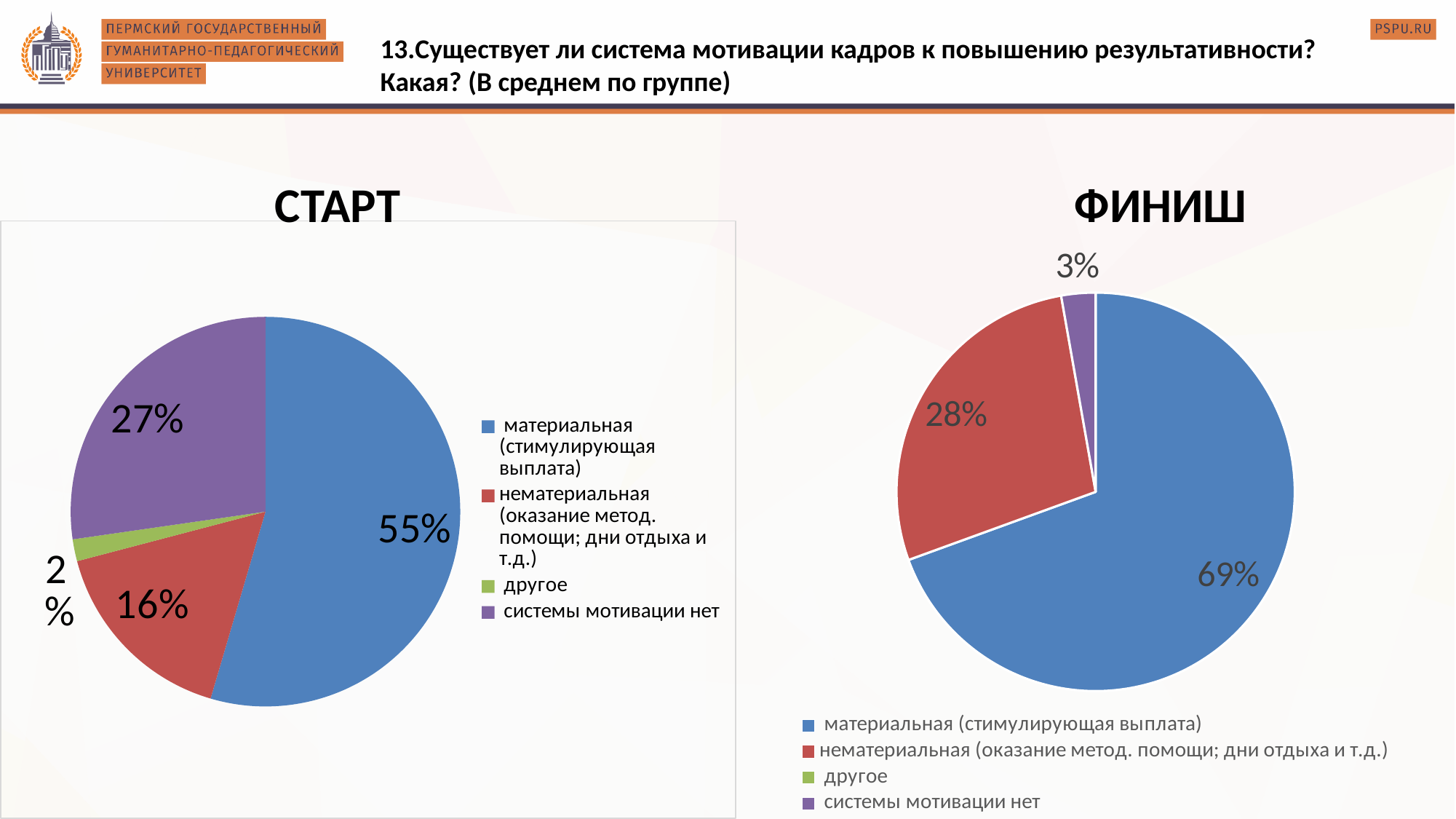
In the СТАРТ chart, what share is labelled for the материальная (стимулирующая выплата) slice? 55% In the СТАРТ chart, what percentage is shown for другое? 2% In the СТАРТ chart, what percentage is shown for нематериальная (оказание метод. помощи; дни отдыха и т.д.)? 16% How many entries does the legend of the ФИНИШ chart list? 4 In the ФИНИШ chart, what percentage is shown for системы мотивации нет? 3% In the ФИНИШ chart, what share is labelled for the материальная (стимулирующая выплата) slice? 69% In the СТАРТ chart, which category has the smallest slice? другое What is the difference between the материальная (стимулирующая выплата) share in the ФИНИШ chart and in the СТАРТ chart? 14% In the ФИНИШ chart, what percentage is shown for нематериальная (оказание метод. помощи; дни отдыха и т.д.)? 28% In the СТАРТ chart, what percentage is shown for системы мотивации нет? 27% What type of chart is used for the СТАРТ data? Pie chart In the ФИНИШ chart, which category has the largest slice? материальная (стимулирующая выплата)